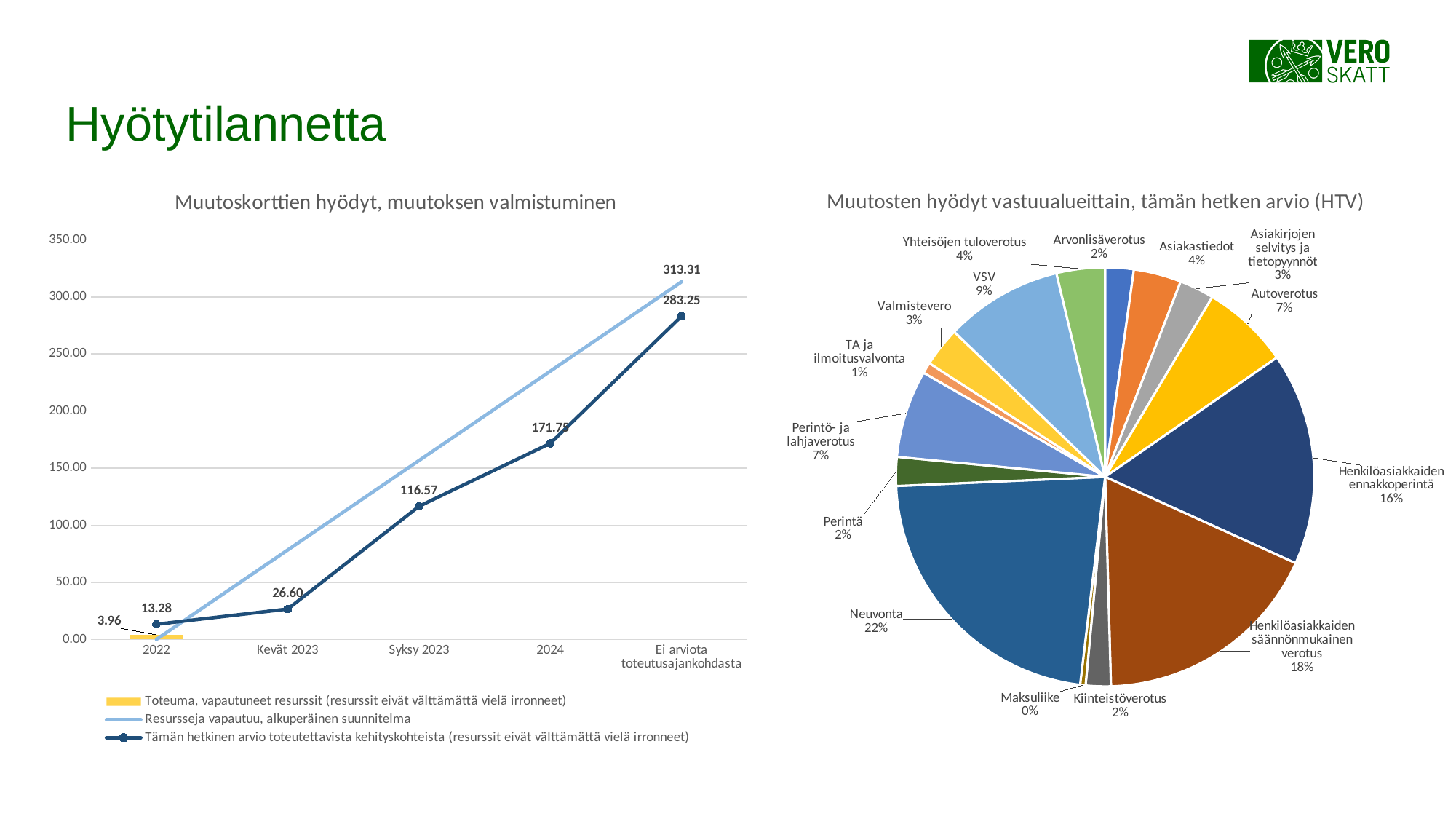
In the pie chart on the right, which is larger: Henkilöasiakkaiden ennakkoperintä or Henkilöasiakkaiden säännönmukainen verotus? Henkilöasiakkaiden säännönmukainen verotus In the left chart, what value does the 'Resursseja vapautuu, alkuperäinen suunnitelma' line reach at 'Ei arviota toteutusajankohdasta'? 313.31 In the left chart, what is the difference between the 'Tämän hetkinen arvio' values at 'Ei arviota toteutusajankohdasta' (283.25) and 2024 (171.75)? 111.50 In the left chart 'Muutoskorttien hyödyt, muutoksen valmistuminen', what is the value of the 'Tämän hetkinen arvio' line at Syksy 2023? 116.57 How many categories are shown on the x axis of the left chart? 5 How many series does the legend of the left chart list? 3 In the pie chart on the right, what is the share of VSV? 9% In the pie chart 'Muutosten hyödyt vastuualueittain', what share does Neuvonta have? 22% What type of chart is the chart on the right of the slide? pie chart In the pie chart on the right, which category has the largest share? Neuvonta In the left chart, what is the value of the 'Toteuma, vapautuneet resurssit' bar for 2022? 3.96 In the left chart, does the 'Tämän hetkinen arvio' line rise or fall from 2022 to 'Ei arviota toteutusajankohdasta'? rise